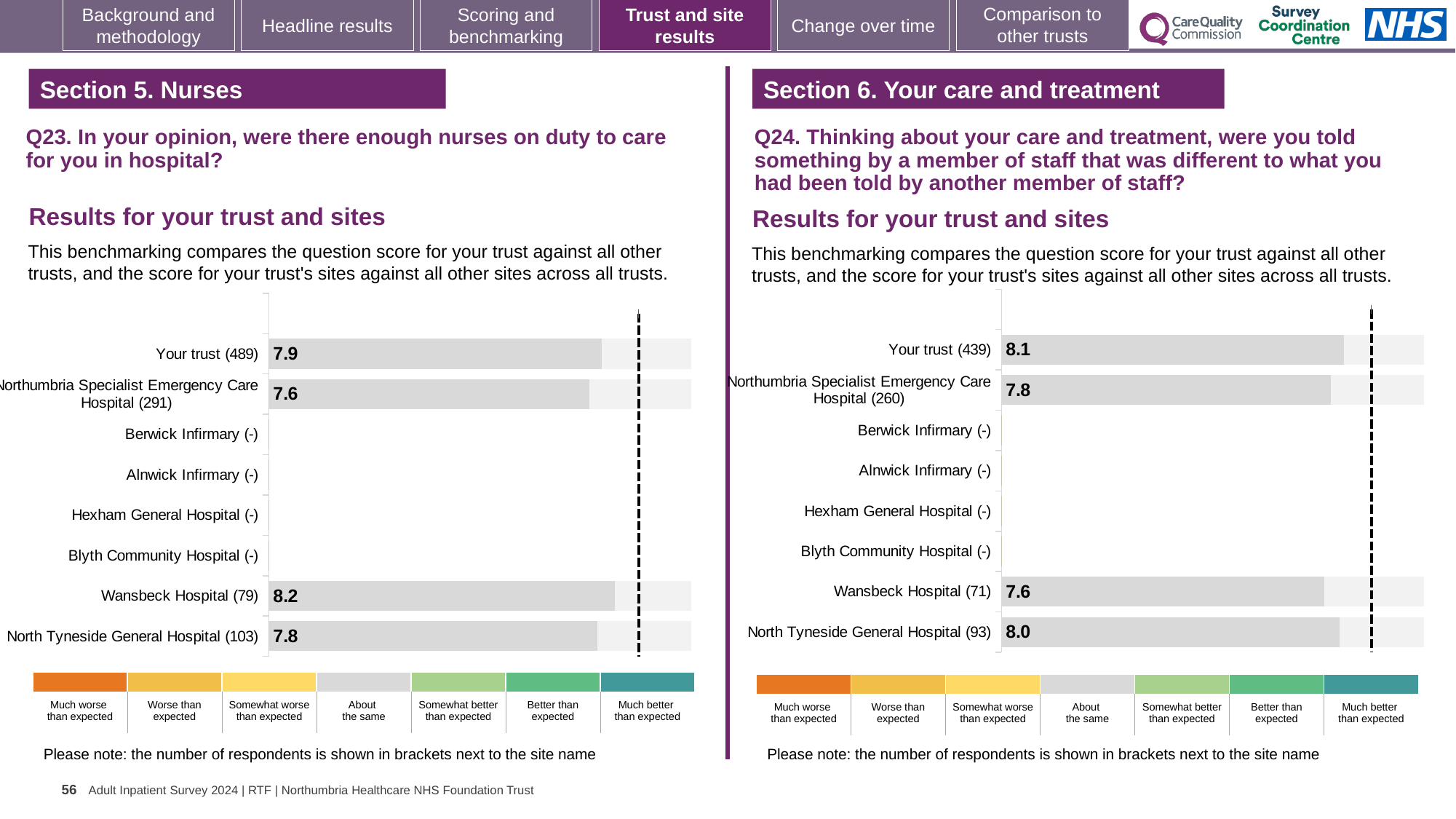
What kind of chart is used on the Q24 chart (right)? Bar chart On the Q23 chart (left), which site has the lowest score among those with a value shown? Northumbria Specialist Emergency Care Hospital On the Q23 chart (left), what is the score for Wansbeck Hospital? 8.2 On the Q24 chart (right), which is larger: the score for Northumbria Specialist Emergency Care Hospital or for North Tyneside General Hospital? North Tyneside General Hospital On the Q24 chart (right), what is the score for Your trust? 8.1 On the Q24 chart (right), which site has the lowest score among those with a value shown? Wansbeck Hospital On the Q24 chart (right), what is the difference between the scores for Your trust and Wansbeck Hospital? 0.5 How many site/trust categories are listed on the Q23 chart (left)? 8 On the Q23 chart (left), what is the difference between the scores for Wansbeck Hospital and North Tyneside General Hospital? 0.4 On the Q24 chart (right), what is the score for North Tyneside General Hospital? 8.0 On the Q23 chart (left), what is the score for Your trust? 7.9 On the Q23 chart (left), which site has the highest score? Wansbeck Hospital